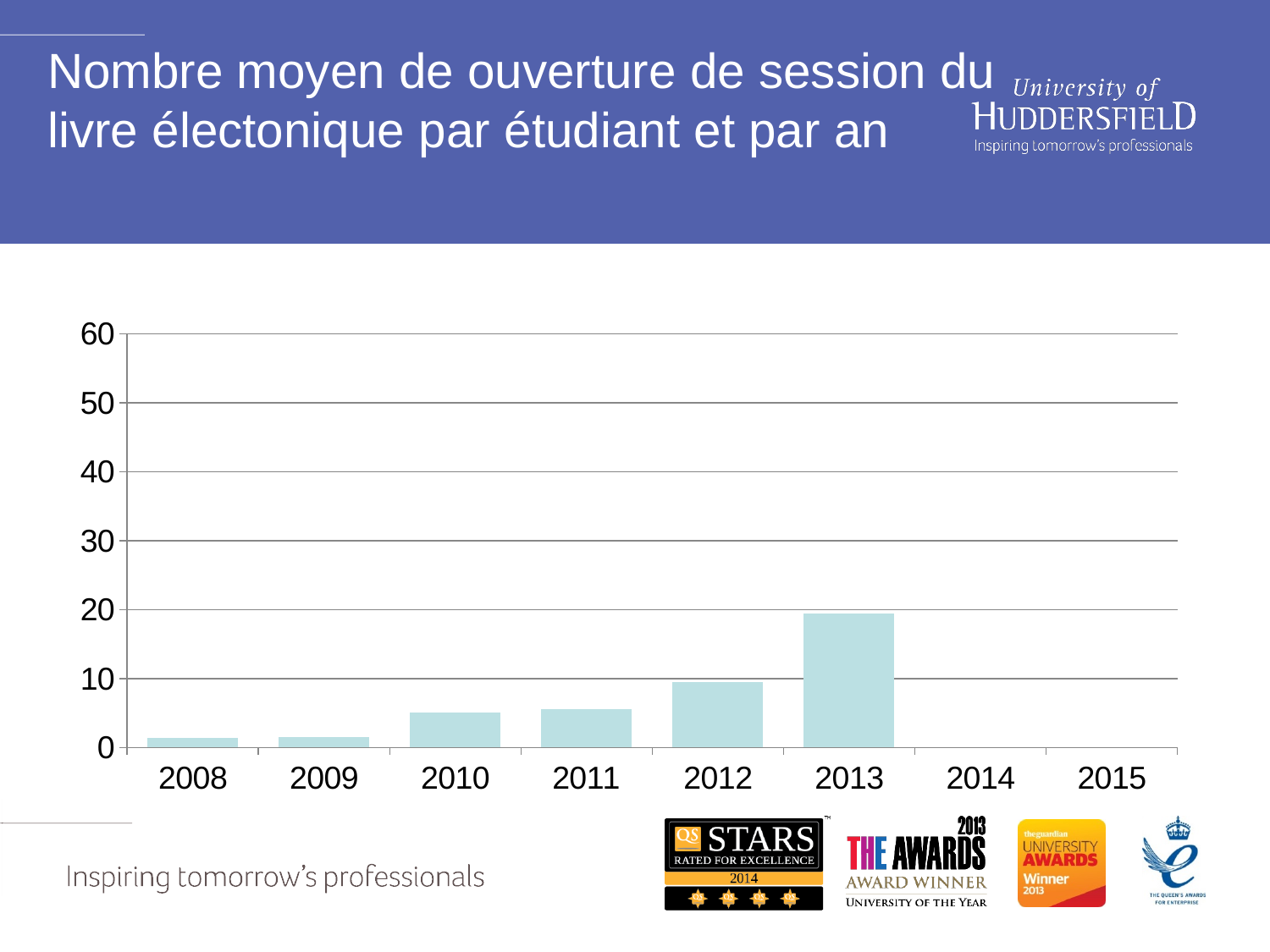
Is the value for 2012 greater or less than 5? greater Do the values rise or fall from 2008 to 2013? rise Which year has the highest value in the chart? 2013 Is the value for 2010 greater or less than 10? less How many years are labelled on the x axis of the chart? 8 Is the value for 2013 greater or less than 30? less What is the highest value shown on the y axis of the chart? 60 Which year has the larger value, 2008 or 2010? 2010 Which year has the larger value, 2012 or 2013? 2013 What kind of chart is shown on the slide? bar chart